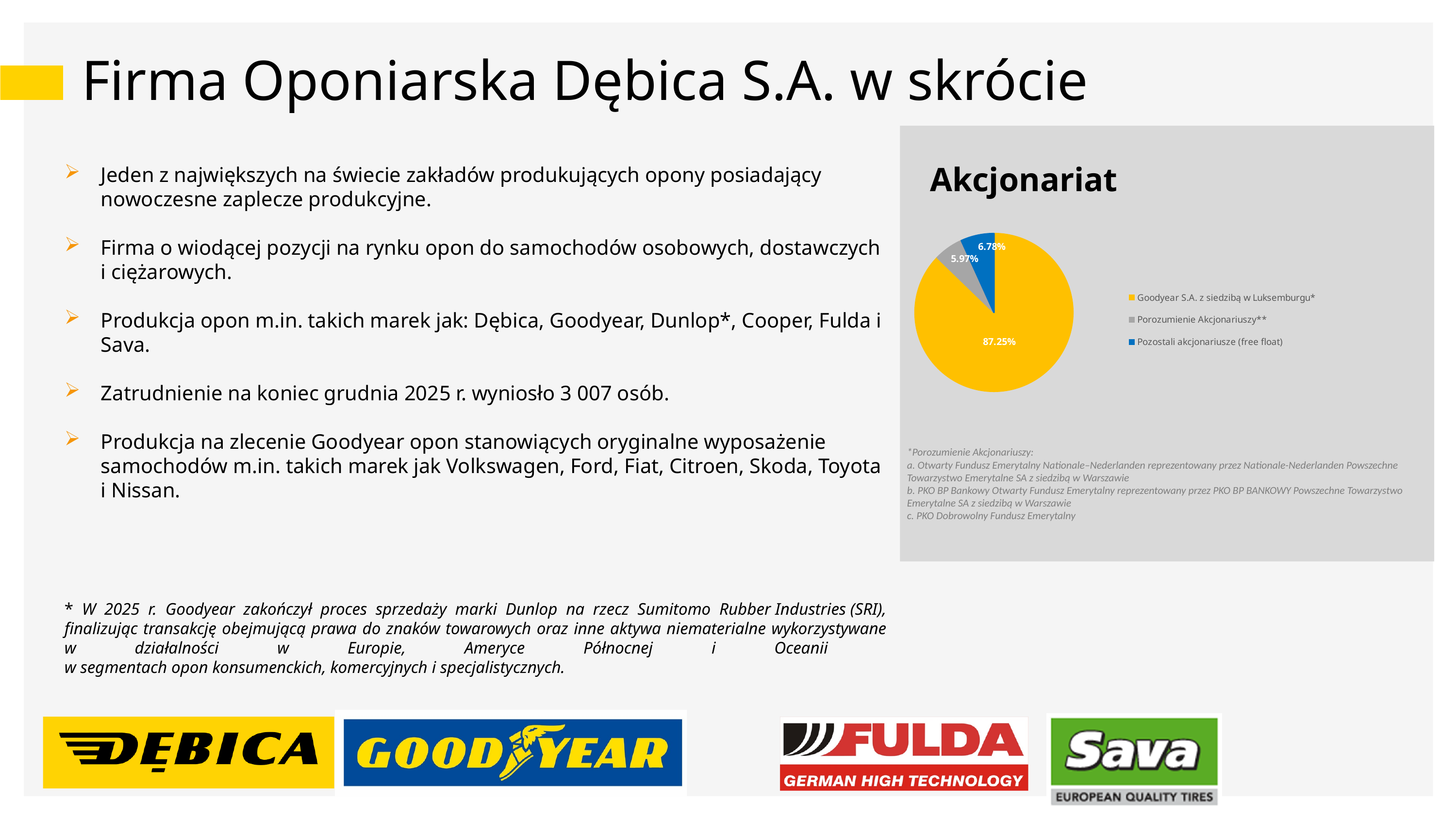
What share of the pie chart belongs to Pozostali akcjonariusze (free float)? 6.78% How many entries does the legend of the pie chart list? 3 Which category has the largest slice in the pie chart? Goodyear S.A. z siedzibą w Luksemburgu* Which category has the smallest slice in the pie chart? Porozumienie Akcjonariuszy** What is the difference between the shares of Pozostali akcjonariusze (free float) and Porozumienie Akcjonariuszy**? 0.81% How many slices does the pie chart have? 3 What share of the pie chart belongs to Porozumienie Akcjonariuszy**? 5.97% What is the title of the chart on the slide? Akcjonariat What kind of chart is shown under the title "Akcjonariat"? pie chart Which is larger in the pie chart: Pozostali akcjonariusze (free float) or Porozumienie Akcjonariuszy**? Pozostali akcjonariusze (free float) What share of the pie chart belongs to Goodyear S.A. z siedzibą w Luksemburgu*? 87.25% What colour is the slice for Goodyear S.A. z siedzibą w Luksemburgu* in the pie chart? yellow